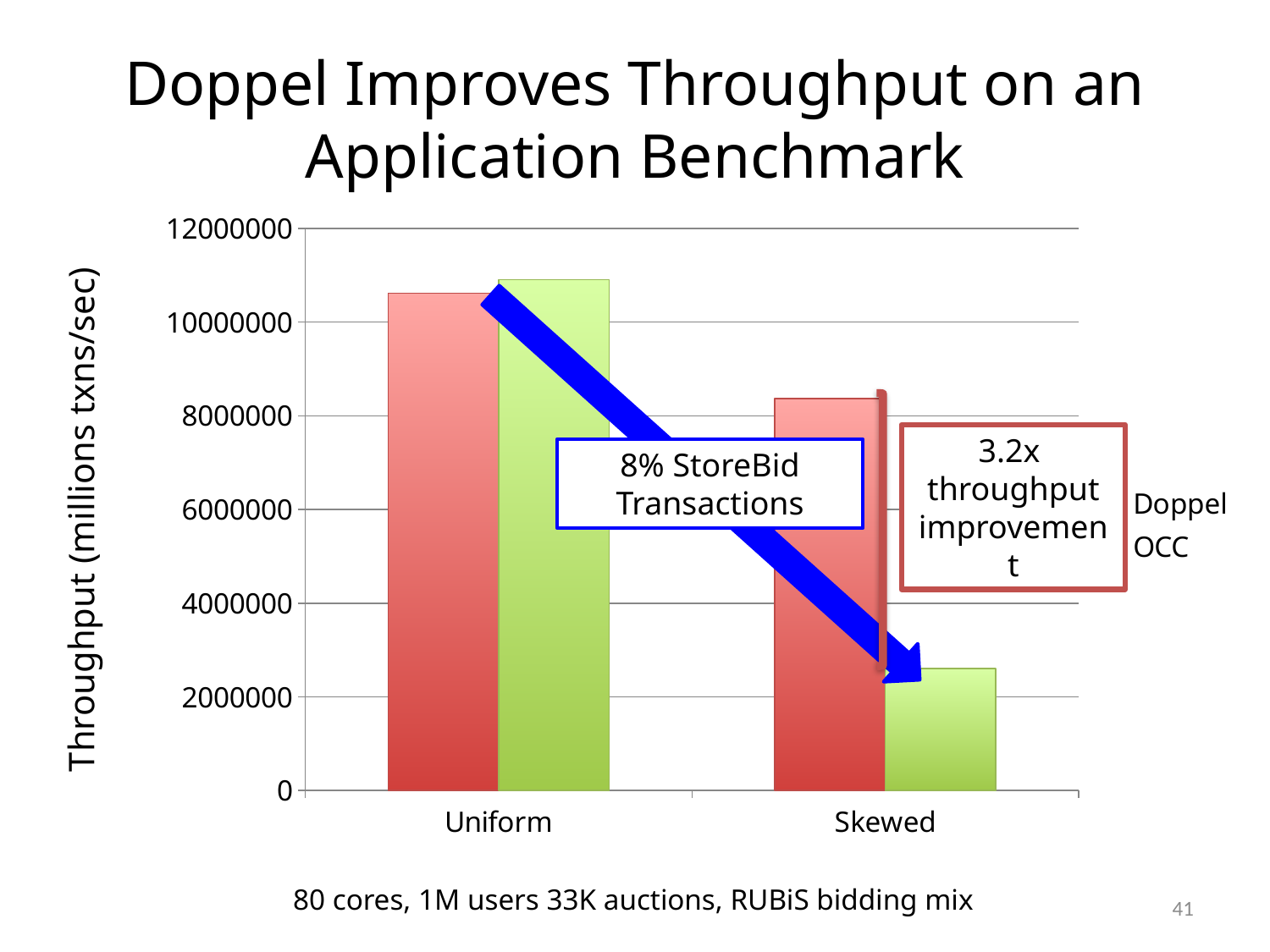
What kind of chart is shown on the slide? bar chart What is the label on the y axis? Throughput (millions txns/sec) Is the Doppel value for Skewed greater or less than 8000000? greater Which series has the lowest bar in the chart? OCC (Skewed) Do the OCC values rise or fall from Uniform to Skewed? fall For OCC, is throughput larger for Uniform or Skewed? Uniform How many series does the legend list? 2 What throughput improvement does the annotation on the chart claim for the Skewed workload? 3.2x Is the OCC value for Skewed greater or less than 4000000? less How many categories are shown on the x axis? 2 For the Skewed workload, which series has the larger throughput, Doppel or OCC? Doppel Is the Doppel value for Uniform greater or less than 10000000? greater